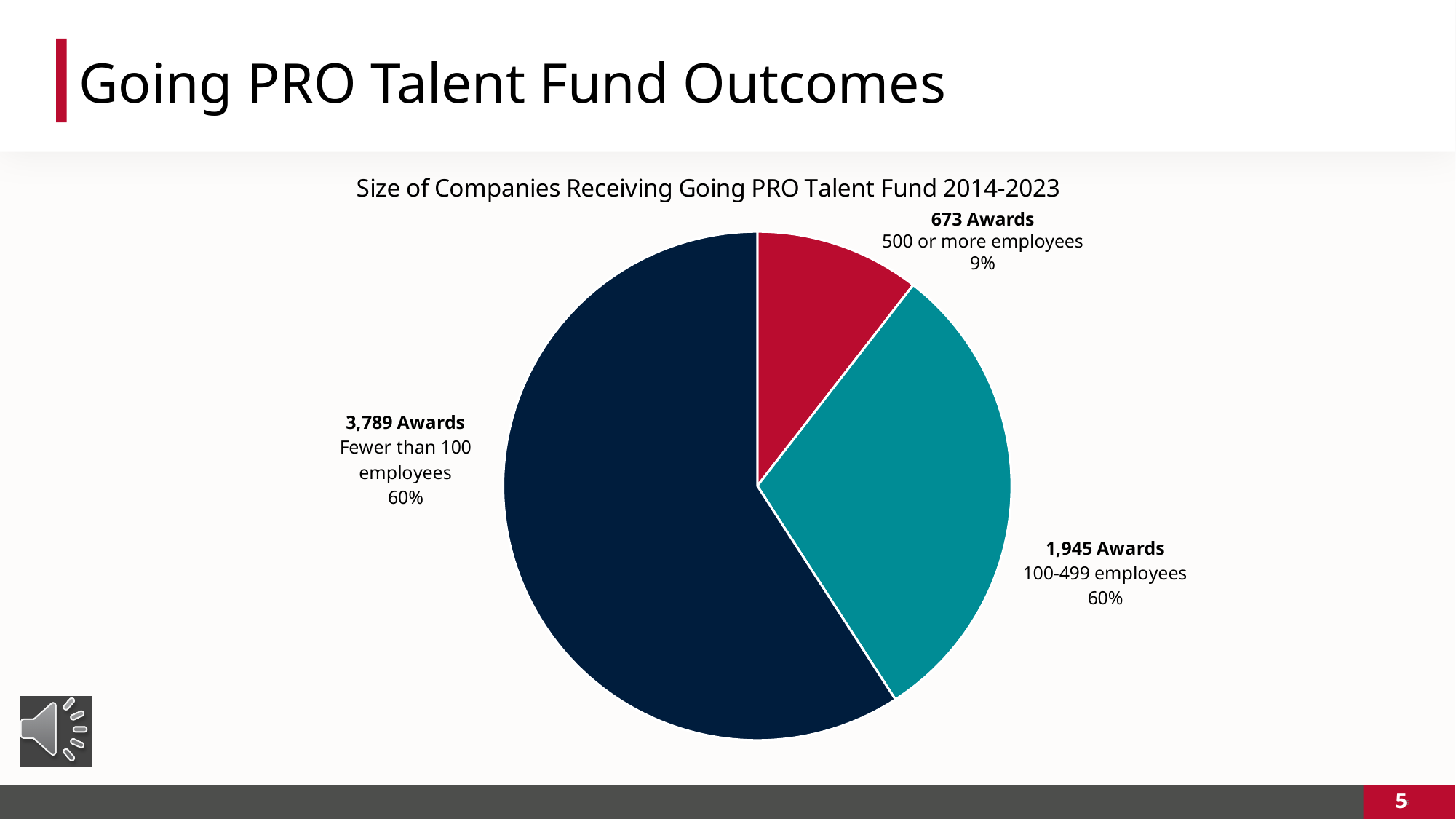
What kind of chart is shown on the slide? pie chart How many more awards did companies with fewer than 100 employees receive than companies with 100-499 employees? 1,844 How many awards went to companies with 100-499 employees? 1,945 Awards What share of the pie is labelled for companies with 500 or more employees? 9% What is the difference in awards between the 100-499 employees category and the 500 or more employees category? 1,272 How many awards went to companies with fewer than 100 employees? 3,789 Awards Which received more awards: companies with 100-499 employees or companies with 500 or more employees? 100-499 employees How many slices does the pie chart have? 3 How many awards went to companies with 500 or more employees? 673 Awards Which company size category received the most awards? Fewer than 100 employees Which company size category received the fewest awards? 500 or more employees What is the title of the chart? Size of Companies Receiving Going PRO Talent Fund 2014-2023